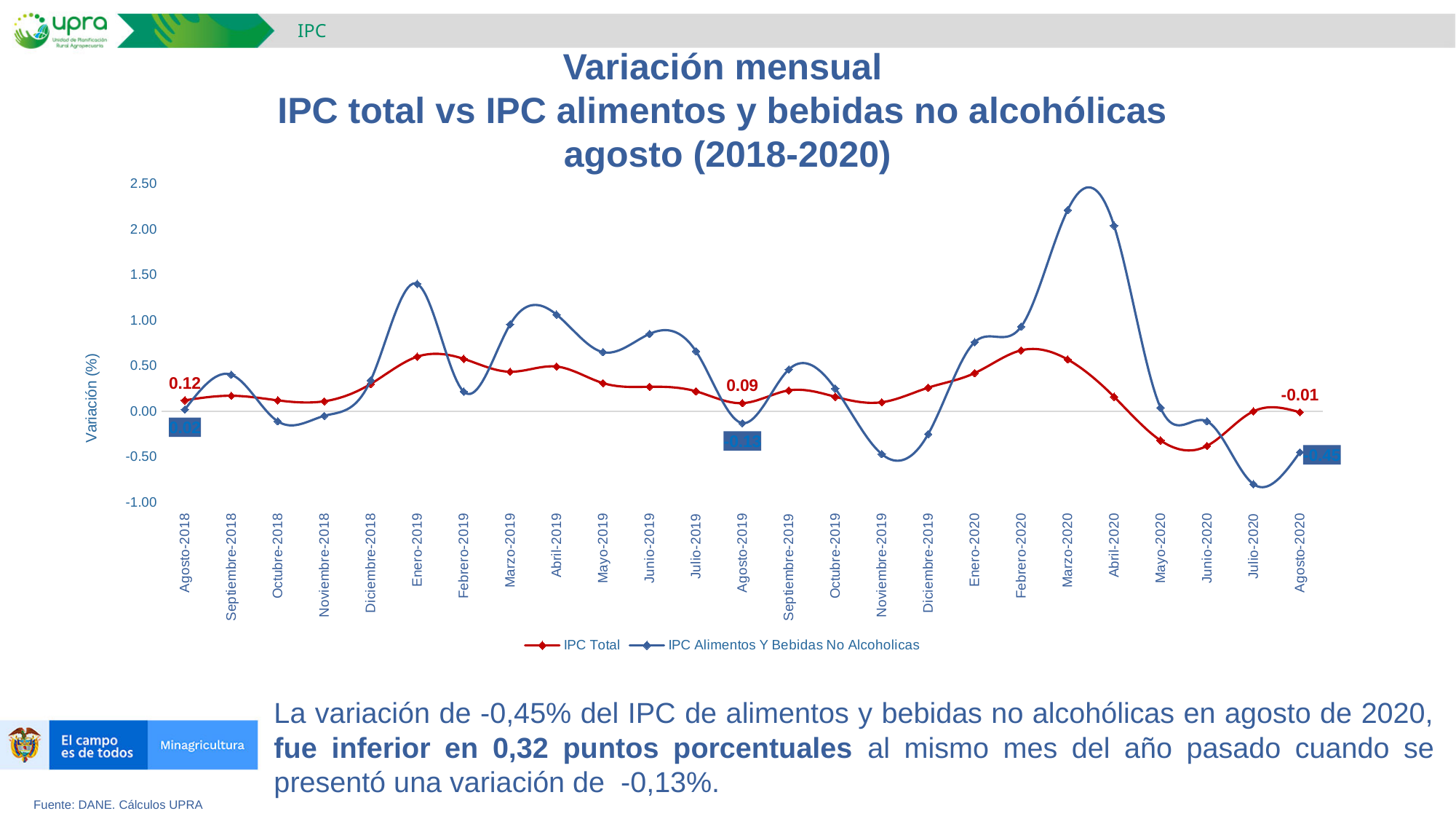
In which month does the IPC Alimentos Y Bebidas No Alcoholicas series reach its highest value? Marzo-2020 What is the value of IPC Total for Agosto-2019? 0.09 What is the value of IPC Total for Agosto-2020? -0.01 Which is larger, the IPC Total value for Agosto-2018 or for Agosto-2020? Agosto-2018 Is the value of IPC Alimentos Y Bebidas No Alcoholicas for Marzo-2020 greater or less than 2.00? greater What is the value of IPC Total for Agosto-2018? 0.12 How many months are plotted along the x axis? 25 What is the difference between the IPC Total values for Agosto-2018 and Agosto-2019? 0.03 Is the value of IPC Alimentos Y Bebidas No Alcoholicas for Julio-2020 greater or less than -0.50? less In which month does the IPC Alimentos Y Bebidas No Alcoholicas series reach its lowest value? Julio-2020 How many series does the legend list? 2 What type of chart is shown on the slide? Line chart